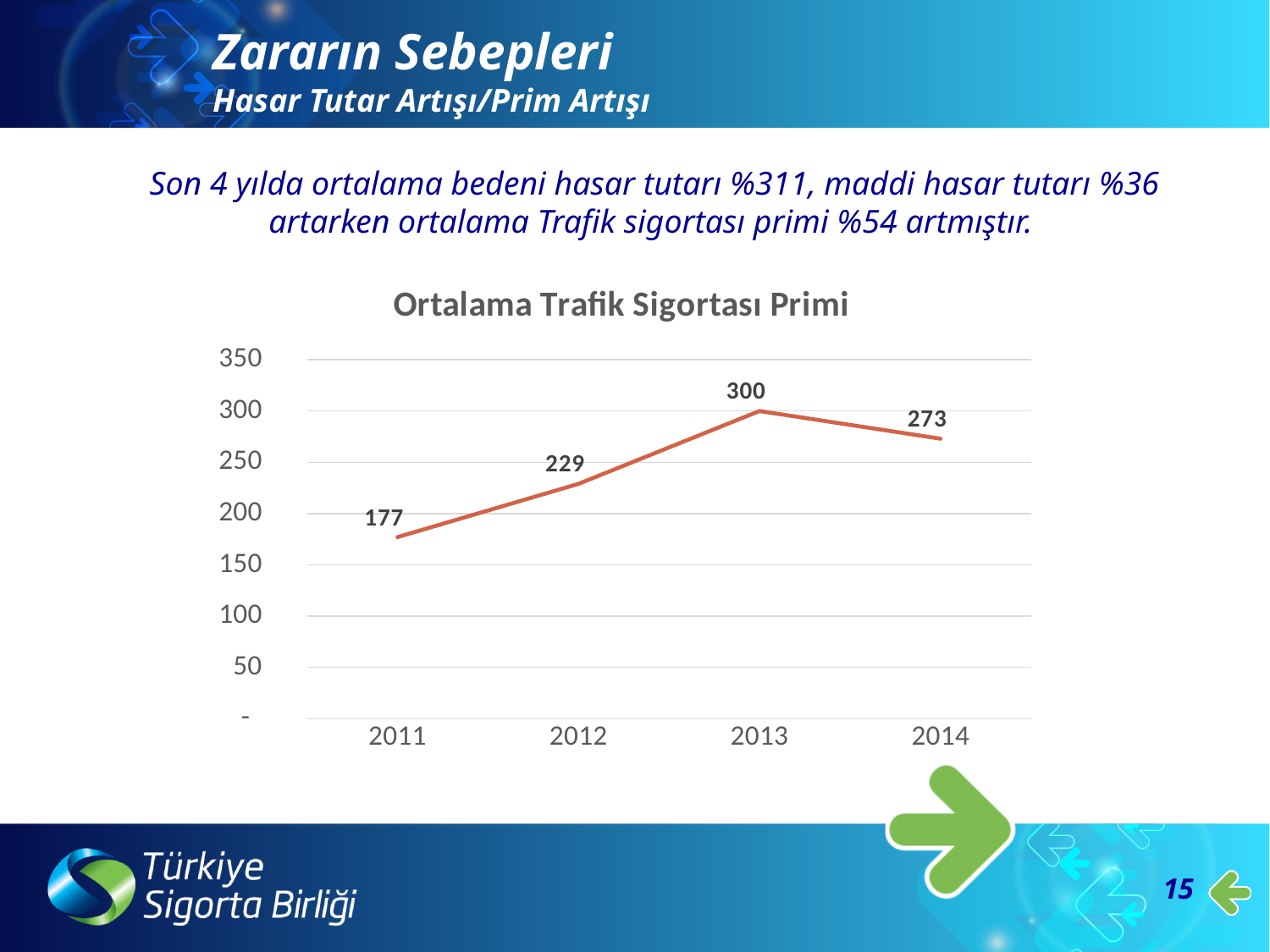
What is the difference between the values for 2013 and 2011? 123 What is the value for 2014? 273 What is the value for 2011? 177 What is the title of the chart? Ortalama Trafik Sigortası Primi What kind of chart is shown? line chart How many years are plotted on the chart? 4 Which is larger, the value for 2012 or the value for 2014? 2014 What is the value for 2013? 300 Which year has the lowest value? 2011 Which year has the highest value? 2013 What is the value for 2012? 229 Does the value rise or fall from 2013 to 2014? fall